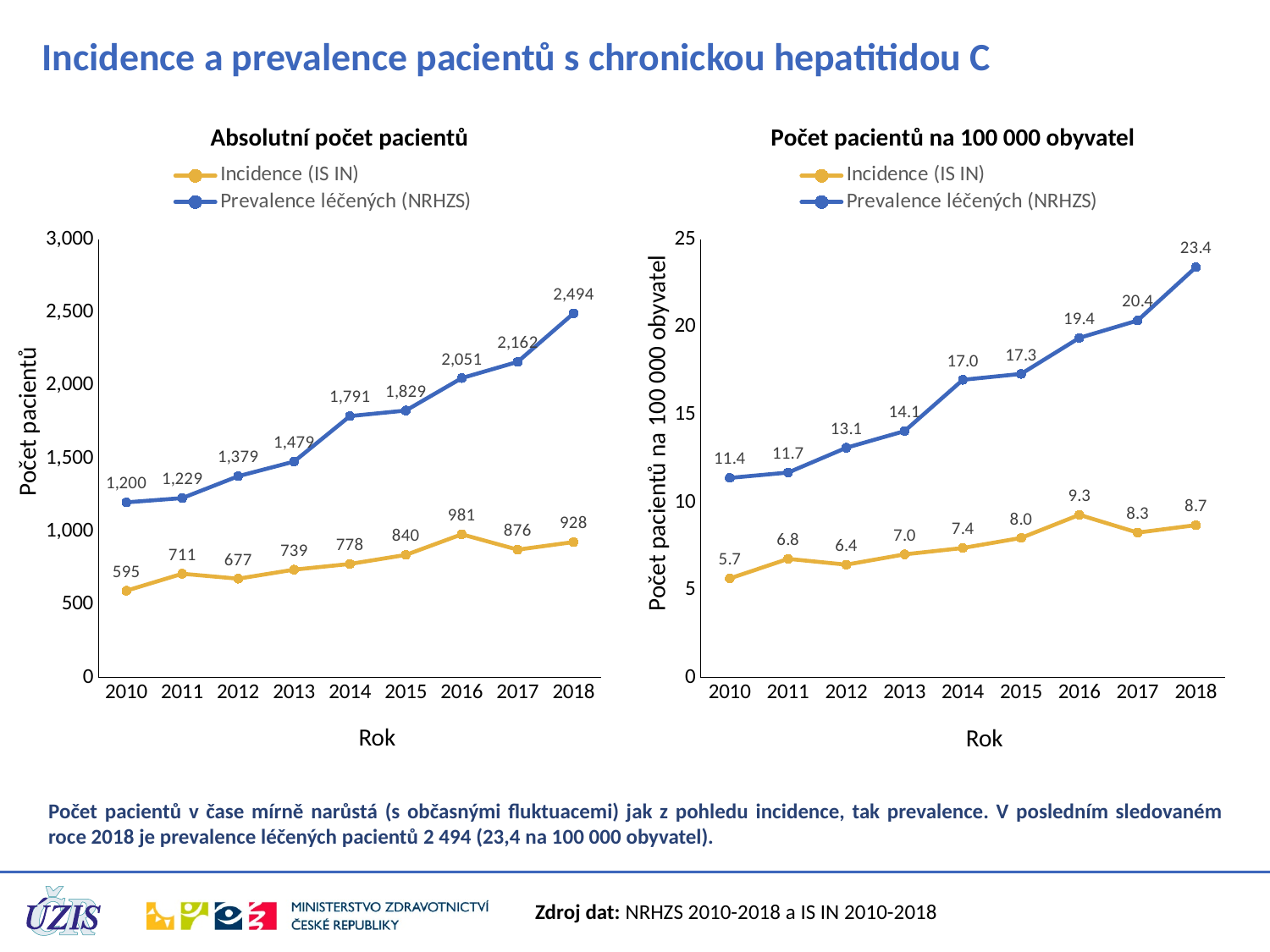
In the 'Absolutní počet pacientů' chart, which is larger: Incidence (IS IN) in 2011 or in 2012? 2011 How many series does the legend of the 'Počet pacientů na 100 000 obyvatel' chart list? 2 In the 'Absolutní počet pacientů' chart, what is the value of Prevalence léčených (NRHZS) in 2018? 2,494 In the 'Absolutní počet pacientů' chart, what is the value of Incidence (IS IN) in 2010? 595 In the 'Počet pacientů na 100 000 obyvatel' chart, what is the value of Prevalence léčených (NRHZS) in 2014? 17.0 What type of chart is the 'Absolutní počet pacientů' chart? Line chart How many years are shown on the x axis of the 'Absolutní počet pacientů' chart? 9 In the 'Absolutní počet pacientů' chart, what is the difference between Prevalence léčených (NRHZS) and Incidence (IS IN) in 2018? 1,566 In the 'Počet pacientů na 100 000 obyvatel' chart, what is the value of Incidence (IS IN) in 2016? 9.3 In the 'Počet pacientů na 100 000 obyvatel' chart, which year has the lowest Incidence (IS IN) value? 2010 In the 'Počet pacientů na 100 000 obyvatel' chart, what is the difference between the Prevalence léčených (NRHZS) values for 2018 and 2017? 3.0 In the 'Absolutní počet pacientů' chart, which year has the highest Incidence (IS IN) value? 2016